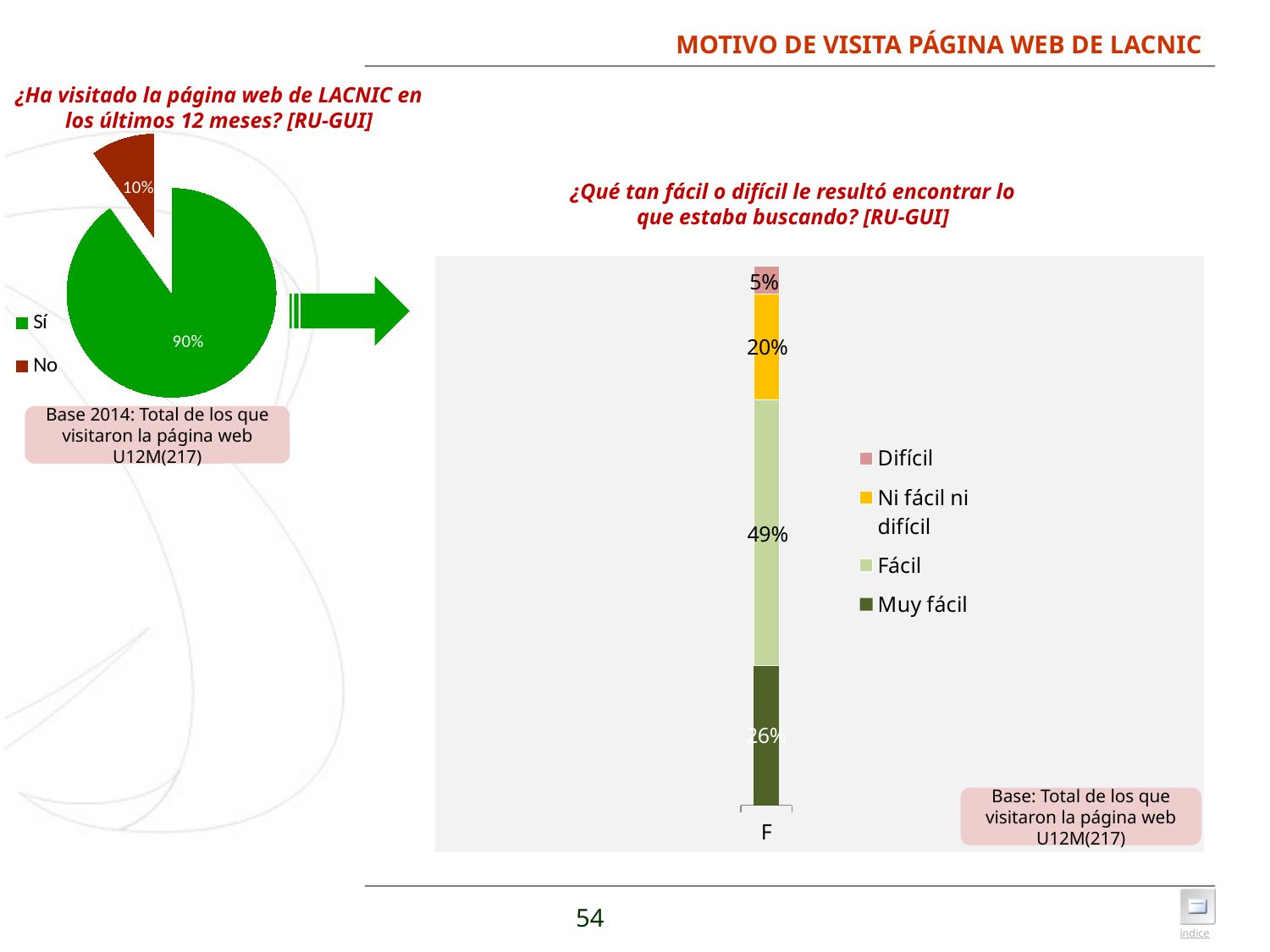
In the stacked bar chart on the right, what is the value for "Difícil"? 5% In the stacked bar chart on the right, what is the value for "Muy fácil"? 26% How many series does the legend of the stacked bar chart on the right list? 4 In the pie chart on the left, what percentage of respondents answered "No"? 10% In the pie chart on the left, which response has the larger share? Sí In the stacked bar chart on the right, which response has the lowest value? Difícil In the stacked bar chart on the right, what is the value for "Fácil"? 49% In the stacked bar chart on the right, what is the total of the stacked bar? 100% In the pie chart on the left, how many slices are there? 2 In the stacked bar chart on the right, what is the difference between "Fácil" and "Ni fácil ni difícil"? 29% In the pie chart on the left, what percentage of respondents answered "Sí"? 90% What type of chart is the chart on the left of the slide? Pie chart